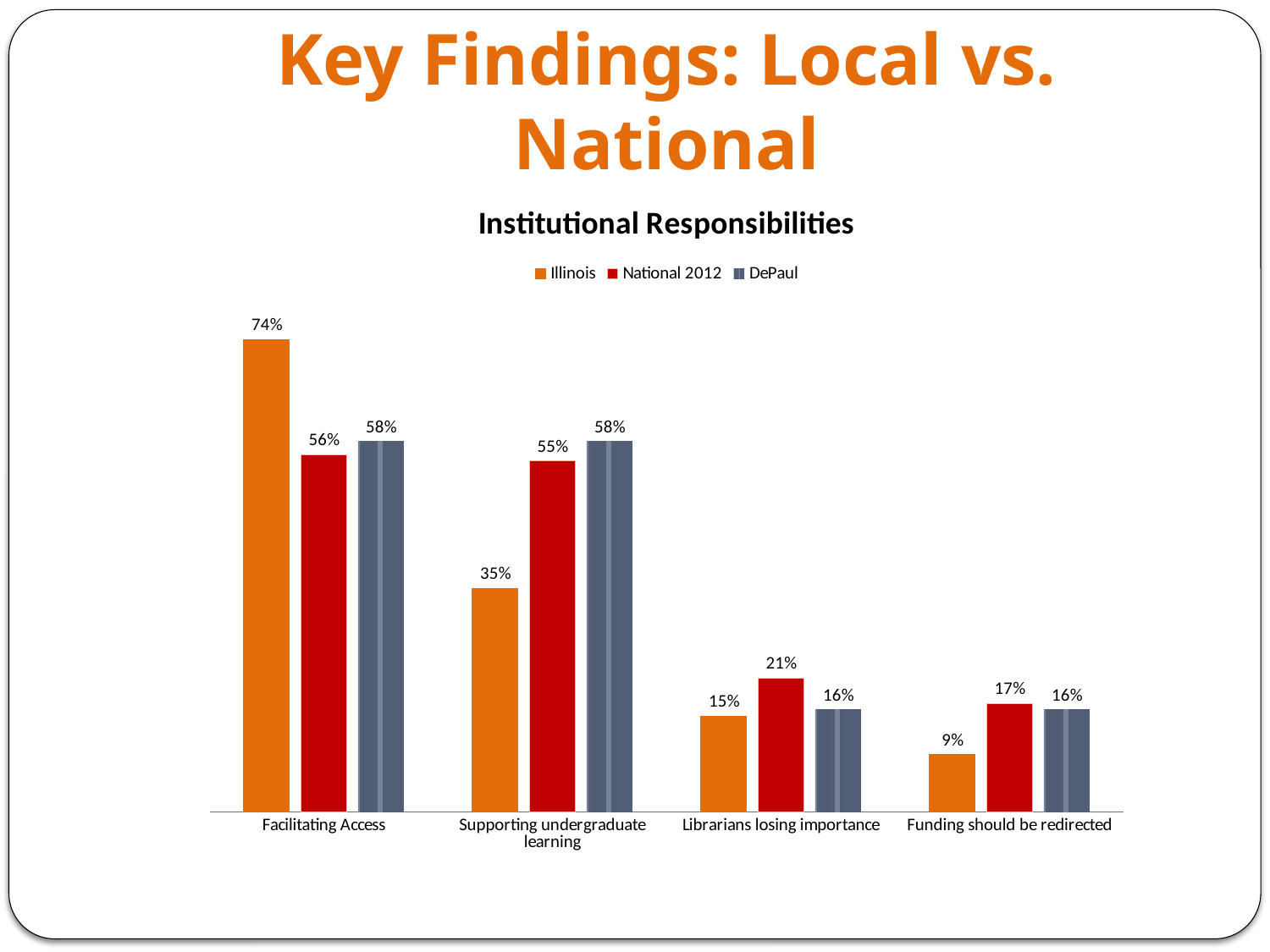
How many categories are shown on the x axis? 4 What is the Illinois value for Facilitating Access? 74% Which category has the lowest National 2012 value? Funding should be redirected How many series does the legend list? 3 What kind of chart is shown on the slide? Bar chart What is the title of the chart? Institutional Responsibilities What is the DePaul value for Librarians losing importance? 16% Which category has the highest Illinois value? Facilitating Access What is the difference between the Illinois and National 2012 values for Facilitating Access? 18% What is the National 2012 value for Supporting undergraduate learning? 55% For Supporting undergraduate learning, which is larger: the Illinois value or the DePaul value? DePaul What is the Illinois value for Funding should be redirected? 9%